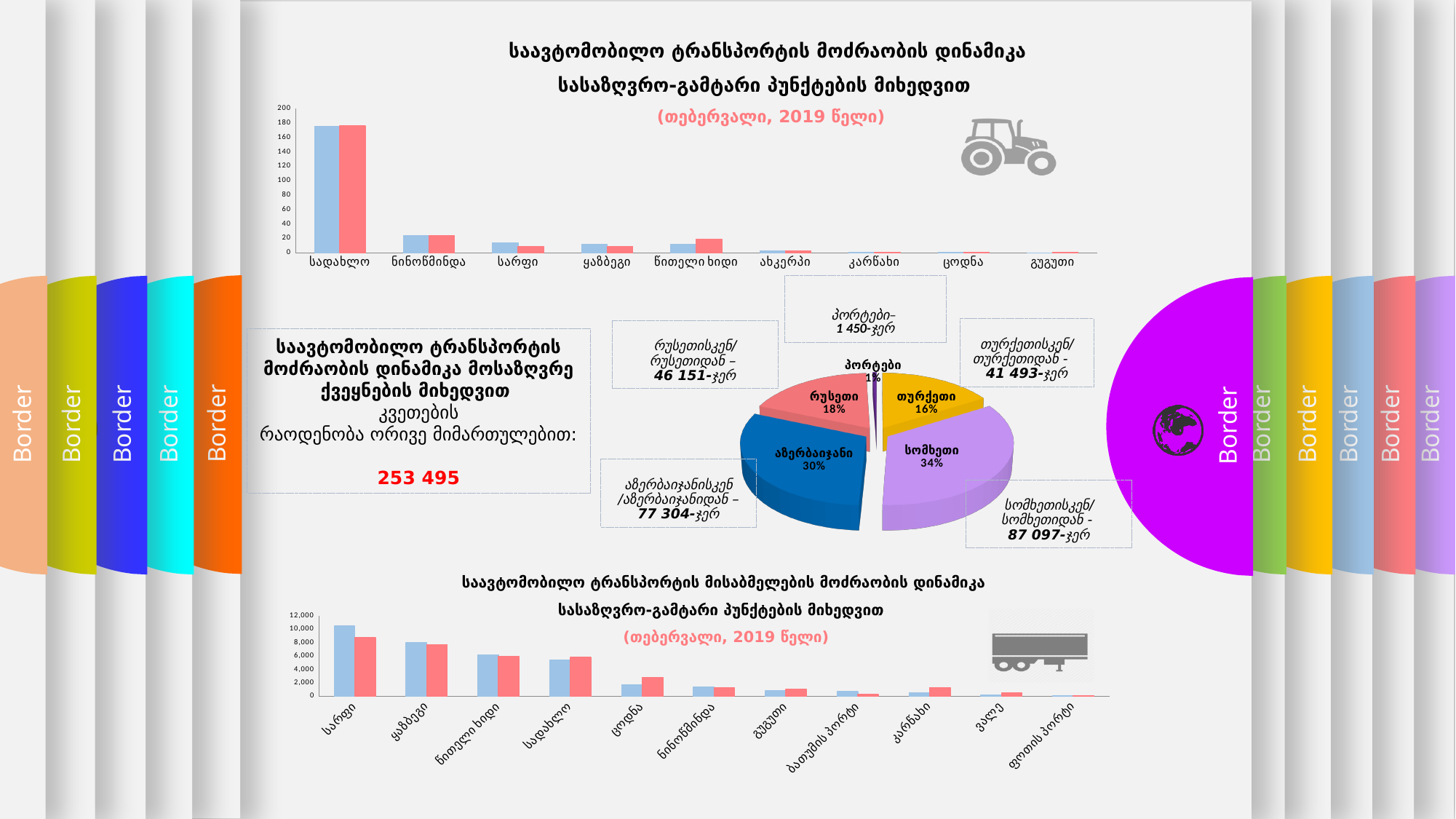
In the top bar chart, is the value of the blue bar for სადახლო greater or less than 160? greater In the pie chart, which slice is the largest? სომხეთი How many categories are shown on the x axis of the top bar chart? 9 In the top bar chart, which category has the highest values? სადახლო In the pie chart, which slice is the smallest? პორტები In the pie chart, what is the difference in percentage points between სომხეთი and აზერბაიჯანი? 4 In the top bar chart, which category has larger bars, ნინოწმინდა or სარფი? ნინოწმინდა What kind of chart is the top chart on the slide? bar chart What kind of chart is the middle chart on the slide? pie chart In the bottom bar chart, is the value of the blue bar for ყაზბეგი greater or less than 6,000? greater In the pie chart, what share does სომხეთი have? 34% How many categories are shown on the x axis of the bottom bar chart? 11